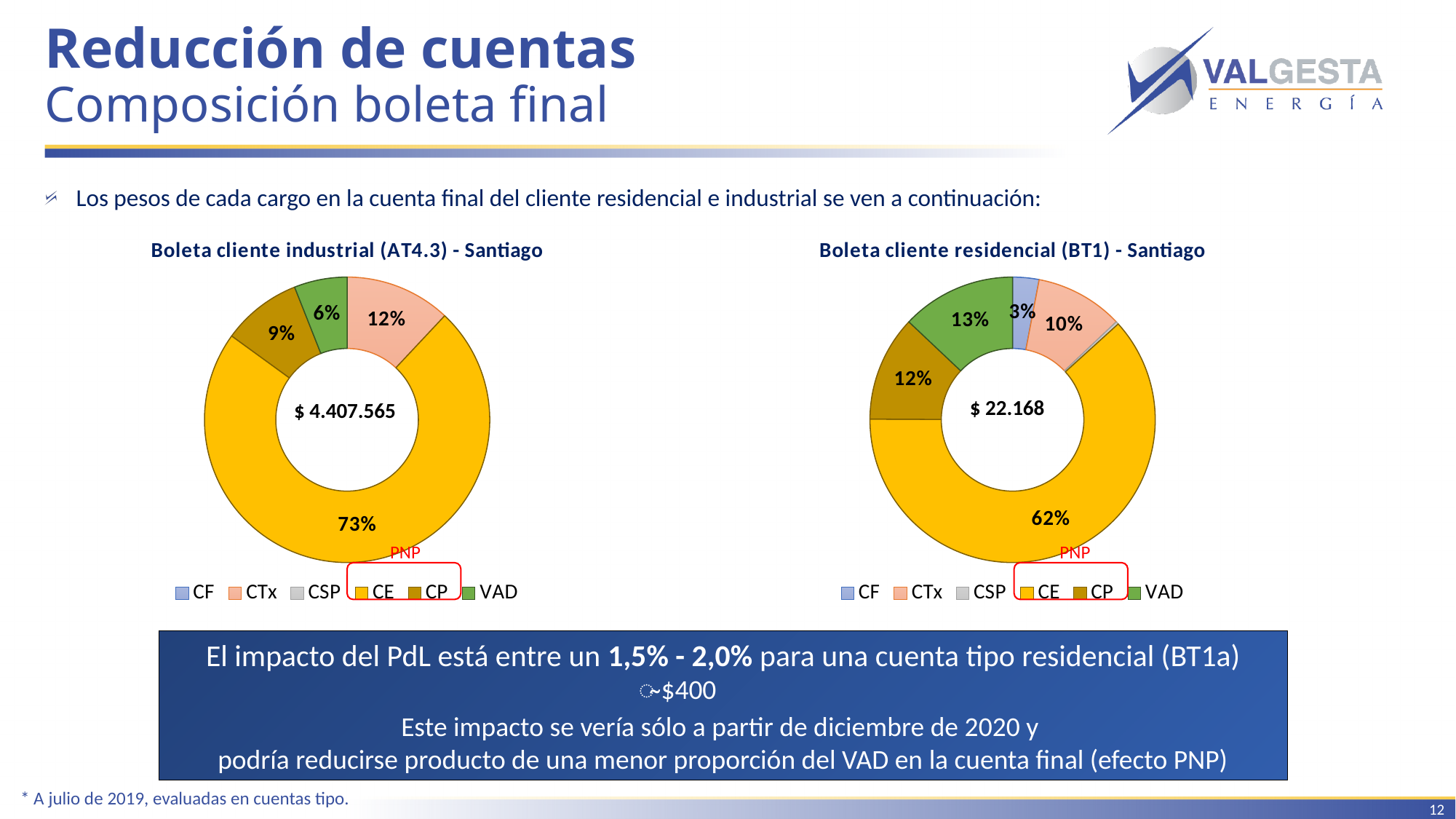
In the 'Boleta cliente industrial (AT4.3) - Santiago' chart, what share does CP have? 9% In the 'Boleta cliente residencial (BT1) - Santiago' chart, what share does CE have? 62% In the 'Boleta cliente residencial (BT1) - Santiago' chart, which category has the largest share? CE In the 'Boleta cliente industrial (AT4.3) - Santiago' chart, what share does CE have? 73% How many percentage points higher is the CE share in the industrial chart than in the residential chart? 11 percentage points In the 'Boleta cliente residencial (BT1) - Santiago' chart, what share does VAD have? 13% What total amount is shown in the centre of the 'Boleta cliente residencial (BT1) - Santiago' chart? $ 22.168 What kind of chart is used on this slide? Pie (donut) chart In the 'Boleta cliente industrial (AT4.3) - Santiago' chart, which category has the largest share? CE How many categories does the legend of the 'Boleta cliente industrial (AT4.3) - Santiago' chart list? 6 In the 'Boleta cliente residencial (BT1) - Santiago' chart, what share does CF have? 3% In the 'Boleta cliente residencial (BT1) - Santiago' chart, which is larger, CTx or CP? CP